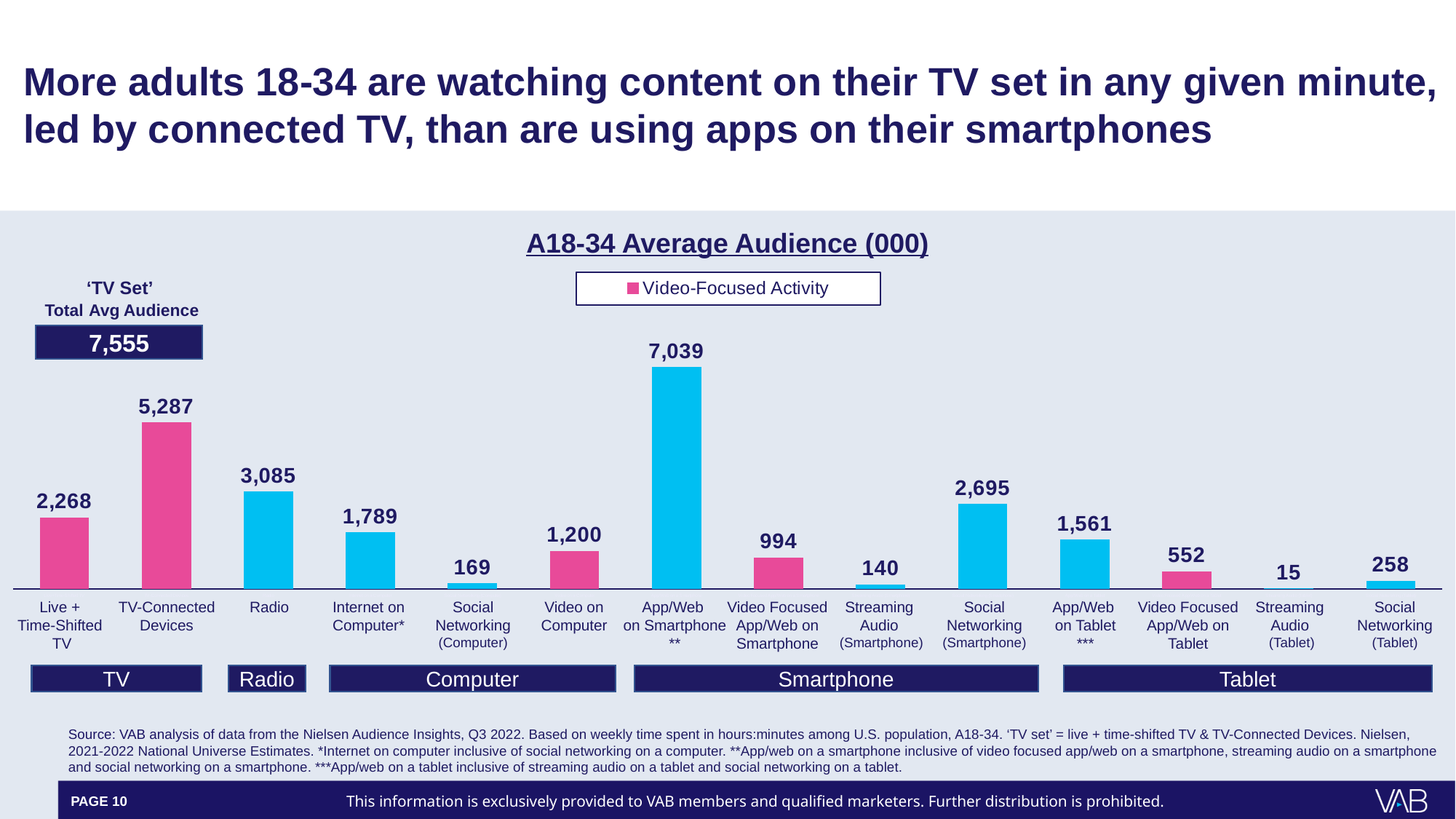
Which is larger, Radio or Social Networking (Smartphone)? Radio What is the 'TV Set' Total Avg Audience shown on the slide? 7,555 What is the title of the chart? A18-34 Average Audience (000) Which category has the highest value? App/Web on Smartphone What is the value for App/Web on Smartphone? 7,039 How many categories are shown in the chart? 14 What is the value for Streaming Audio (Tablet)? 15 What does the legend entry with the pink colour represent? Video-Focused Activity What kind of chart is this? Bar chart What is the value for TV-Connected Devices? 5,287 What is the difference between App/Web on Smartphone and TV-Connected Devices? 1,752 Which category has the lowest value? Streaming Audio (Tablet)